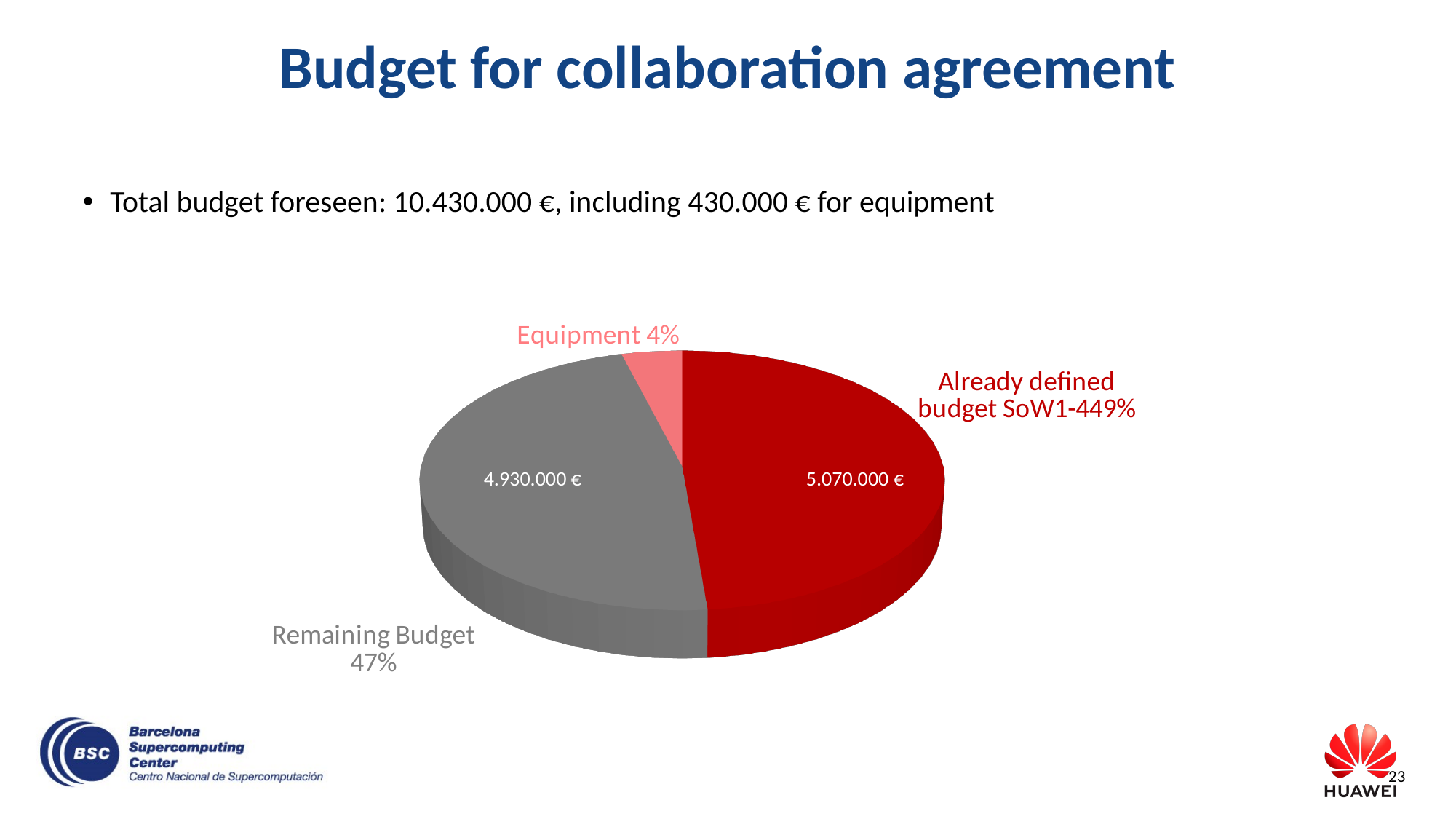
What value is printed on the Already defined budget SoW1-4 slice? 5.070.000 € What colour is the Remaining Budget slice? grey Which slice of the pie chart is the smallest? Equipment What share of the pie does the Remaining Budget slice represent? 47% How many slices does the pie chart have? 3 Which slice of the pie chart is the largest? Already defined budget SoW1-4 What value is printed on the Remaining Budget slice? 4.930.000 € What is the difference between the Already defined budget SoW1-4 value and the Remaining Budget value? 140.000 € What kind of chart is shown on the slide? pie chart What share of the pie does the Already defined budget SoW1-4 slice represent? 49% Which is larger, the Remaining Budget value or the Already defined budget SoW1-4 value? Already defined budget SoW1-4 What share of the pie does the Equipment slice represent? 4%